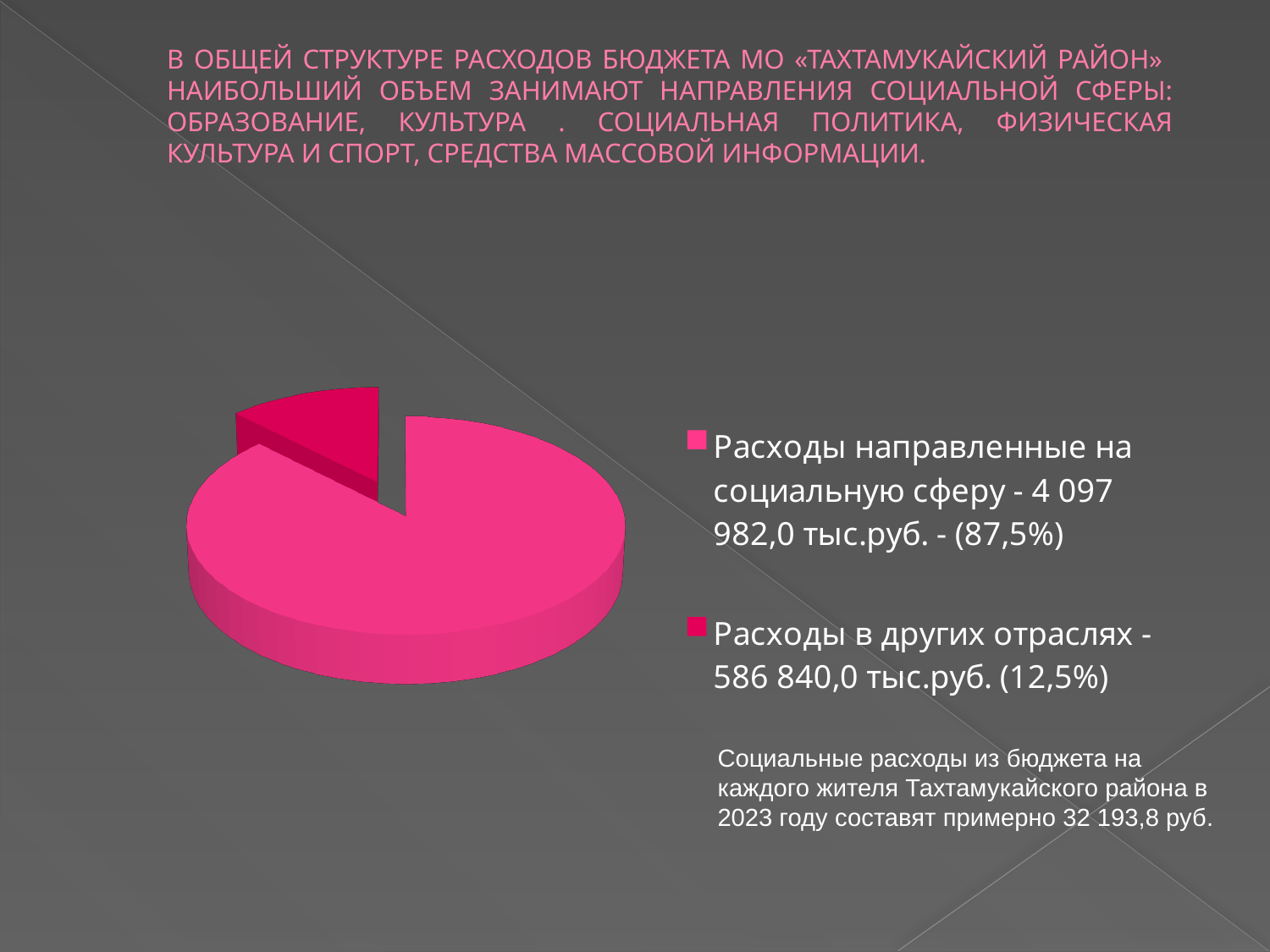
What share of the pie does "Расходы в других отраслях" take? 12,5% Which slice of the pie chart is the smallest? Расходы в других отраслях What kind of chart is shown on the slide? Pie chart What is the value in тыс.руб. for "Расходы в других отраслях"? 586 840,0 тыс.руб. Which is larger: "Расходы направленные на социальную сферу" or "Расходы в других отраслях"? Расходы направленные на социальную сферу By how many percentage points does the share of "Расходы направленные на социальную сферу" exceed the share of "Расходы в других отраслях"? 75 How many entries does the legend of the pie chart list? 2 What share of the pie does "Расходы направленные на социальную сферу" take? 87,5% How many slices does the pie chart have? 2 What is the total of the two values shown in the legend, in тыс.руб.? 4 684 822,0 тыс.руб. What is the value in тыс.руб. for "Расходы направленные на социальную сферу"? 4 097 982,0 тыс.руб. Which slice of the pie chart is the largest? Расходы направленные на социальную сферу